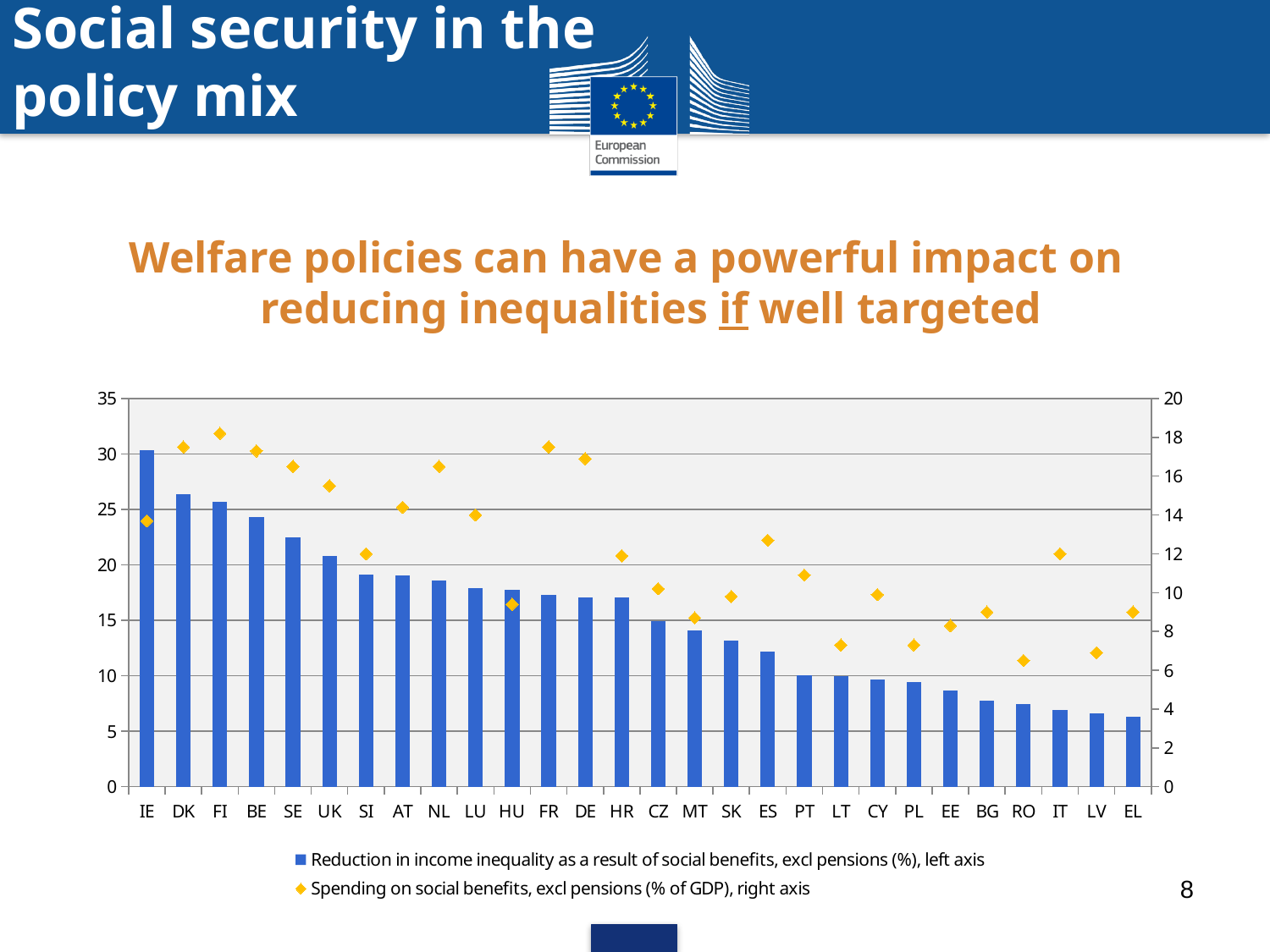
Is the bar for UK (reduction in income inequality, left axis) greater or less than 20? greater Is the diamond for FI (spending on social benefits, right axis) greater or less than 16? greater Which country has the highest bar for reduction in income inequality as a result of social benefits? IE How many countries are shown on the x axis of the chart? 28 Which country has the lowest bar for reduction in income inequality as a result of social benefits? EL How many series does the chart legend list? 2 Is the bar for IE (reduction in income inequality, left axis) greater or less than 25? greater Do the bars for reduction in income inequality rise or fall moving from left to right along the x axis? fall Which is larger: the spending on social benefits (diamond, right axis) for FR or for HU? FR What kind of chart is shown on the slide? A combined bar and scatter (diamond marker) chart Which series in the legend is plotted against the right axis? Spending on social benefits, excl pensions (% of GDP)